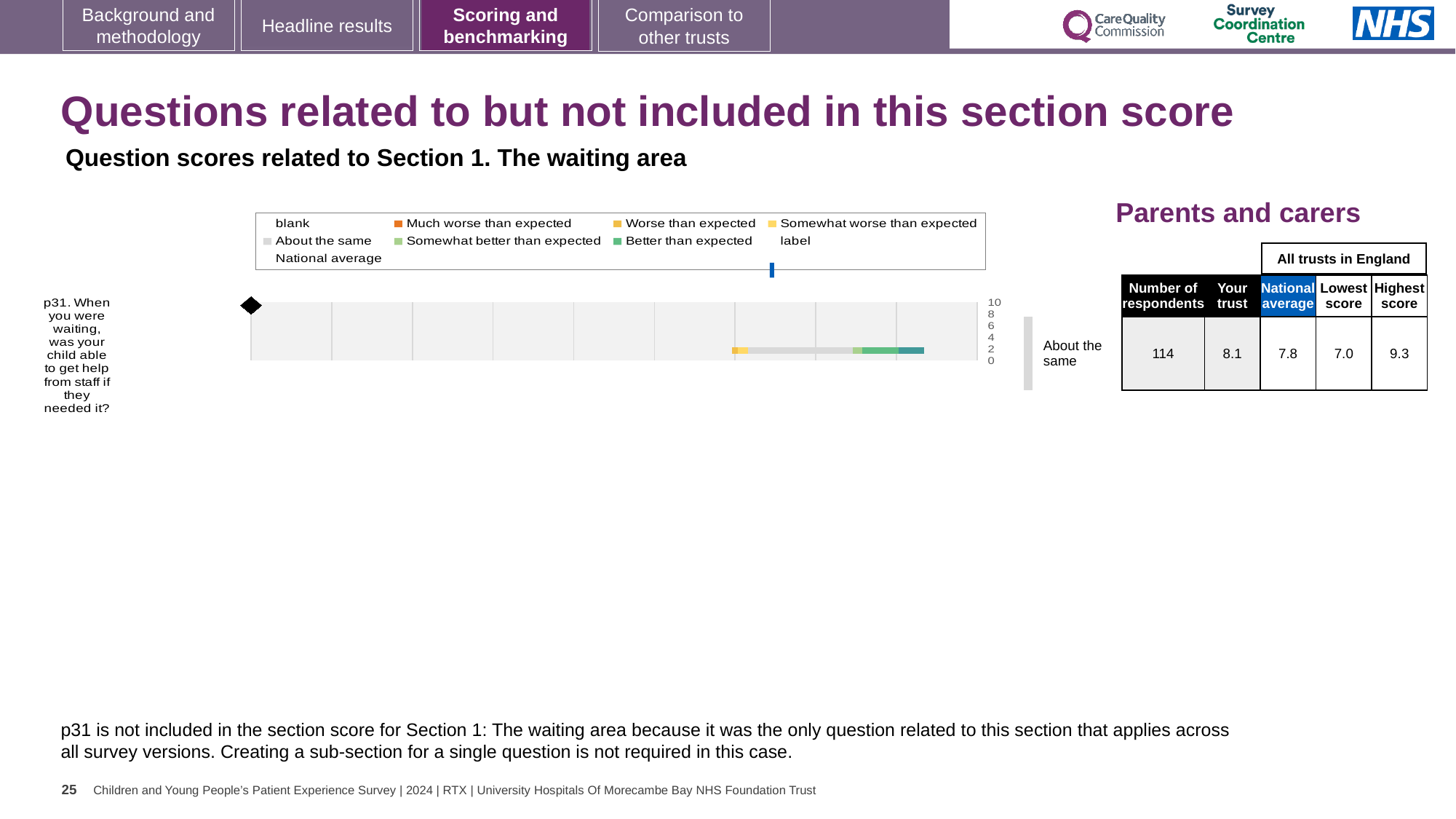
How many respondents answered p31? 114 What kind of chart is used to show the p31 question score? bar chart In the table, what is the 'Your trust' score for p31? 8.1 Is the 'Your trust' score for p31 larger or smaller than the National average? larger In the table, what is the Lowest score across all trusts in England for p31? 7.0 In the table, what is the National average score for p31? 7.8 What is the difference between the Highest score and the Lowest score for p31? 2.3 What is the highest value shown on the chart's axis? 10 Which question is plotted in the chart? p31. When you were waiting, was your child able to get help from staff if they needed it? What benchmark category label is shown to the right of the p31 bar? About the same How many questions are plotted in the chart? 1 In the table, what is the Highest score across all trusts in England for p31? 9.3